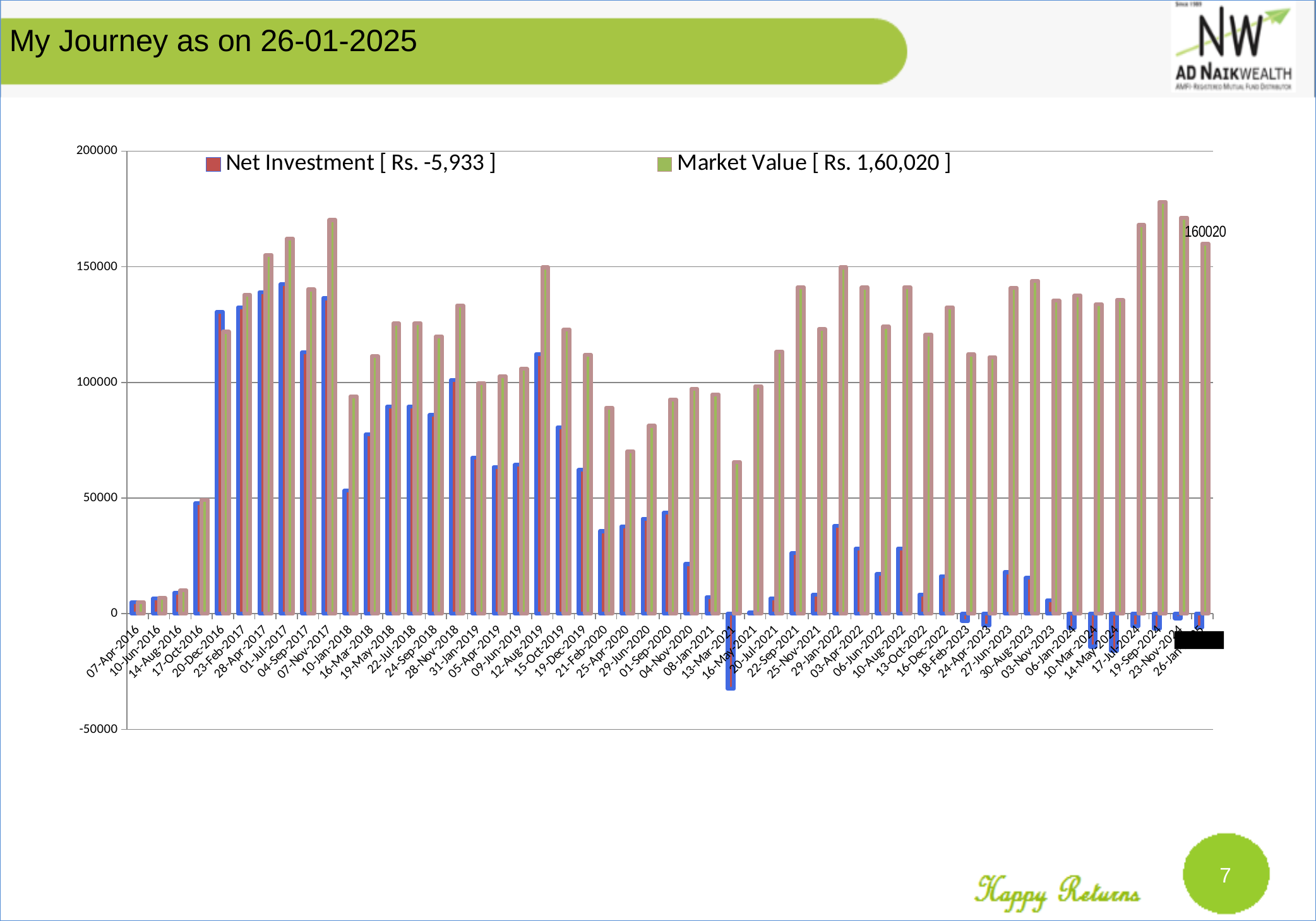
Which has the larger Market Value, 07-Nov-2017 or 10-Jan-2018? 07-Nov-2017 Is the Market Value for 07-Nov-2017 greater or less than 150000? greater Which date has the highest Market Value bar? 19-Sep-2024 What kind of chart is shown on the slide? bar chart What amount is shown in the legend entry for Net Investment? Rs. -5,933 Does the Net Investment rise or fall from 07-Apr-2016 to 01-Jul-2017? rise Which date has the lowest Net Investment bar? 13-Mar-2021 Is the Net Investment for 01-Jul-2017 greater or less than 100000? greater Which has the larger Net Investment, 17-Oct-2016 or 20-Dec-2016? 20-Dec-2016 What is the Market Value shown by the data label on the final bar of the chart? 160020 How many series does the chart's legend list? 2